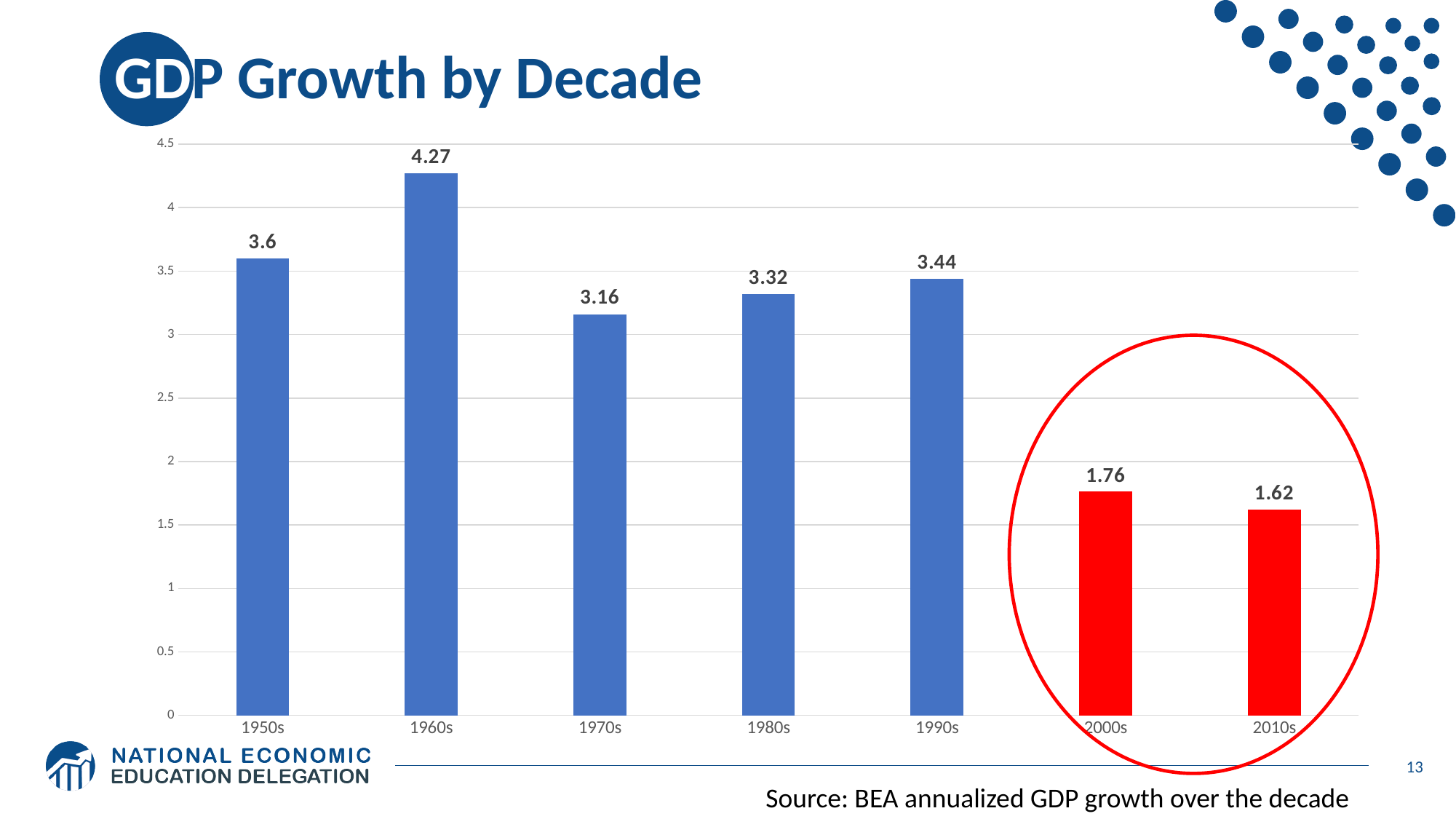
Which decade has higher GDP growth, the 1990s or the 1980s? 1990s Which decade has the lowest GDP growth? 2010s How many decades are shown on the chart? 7 What is the GDP growth value shown for the 1960s? 4.27 Is the value for the 2000s greater or less than 2? less Which bars are coloured red on the chart? 2000s and 2010s What is the GDP growth value shown for the 2010s? 1.62 What kind of chart is shown on the slide? Bar chart What is the GDP growth value shown for the 1980s? 3.32 What is the difference between the GDP growth of the 1960s and the 2010s? 2.65 Which decade has the highest GDP growth? 1960s What is the difference between the GDP growth of the 1950s and the 1970s? 0.44